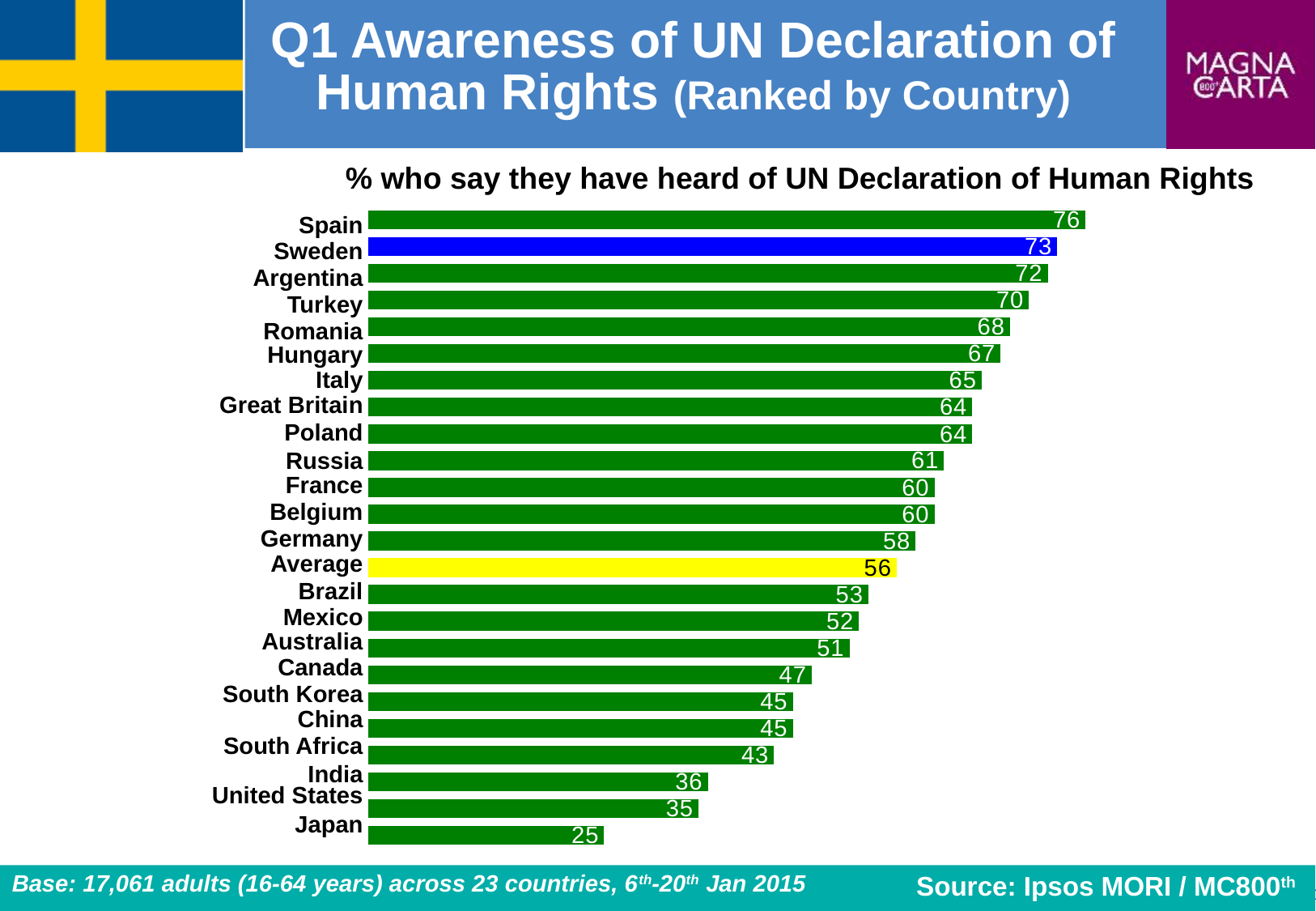
What is the value shown for the Average bar? 56 Which has a higher value, Germany or Brazil? Germany Which country has the lowest percentage who say they have heard of the UN Declaration of Human Rights? Japan How many bars are plotted on the chart, including the Average bar? 24 What is the difference between the values for Sweden and the Average? 17 What is the value shown for Sweden? 73 What is the difference between the values for Spain and Japan? 51 What type of chart is shown on the slide? Bar chart What is the value shown for Japan? 25 Which bar on the chart is coloured blue? Sweden Which country has the highest percentage who say they have heard of the UN Declaration of Human Rights? Spain What percentage of people in Spain say they have heard of the UN Declaration of Human Rights? 76